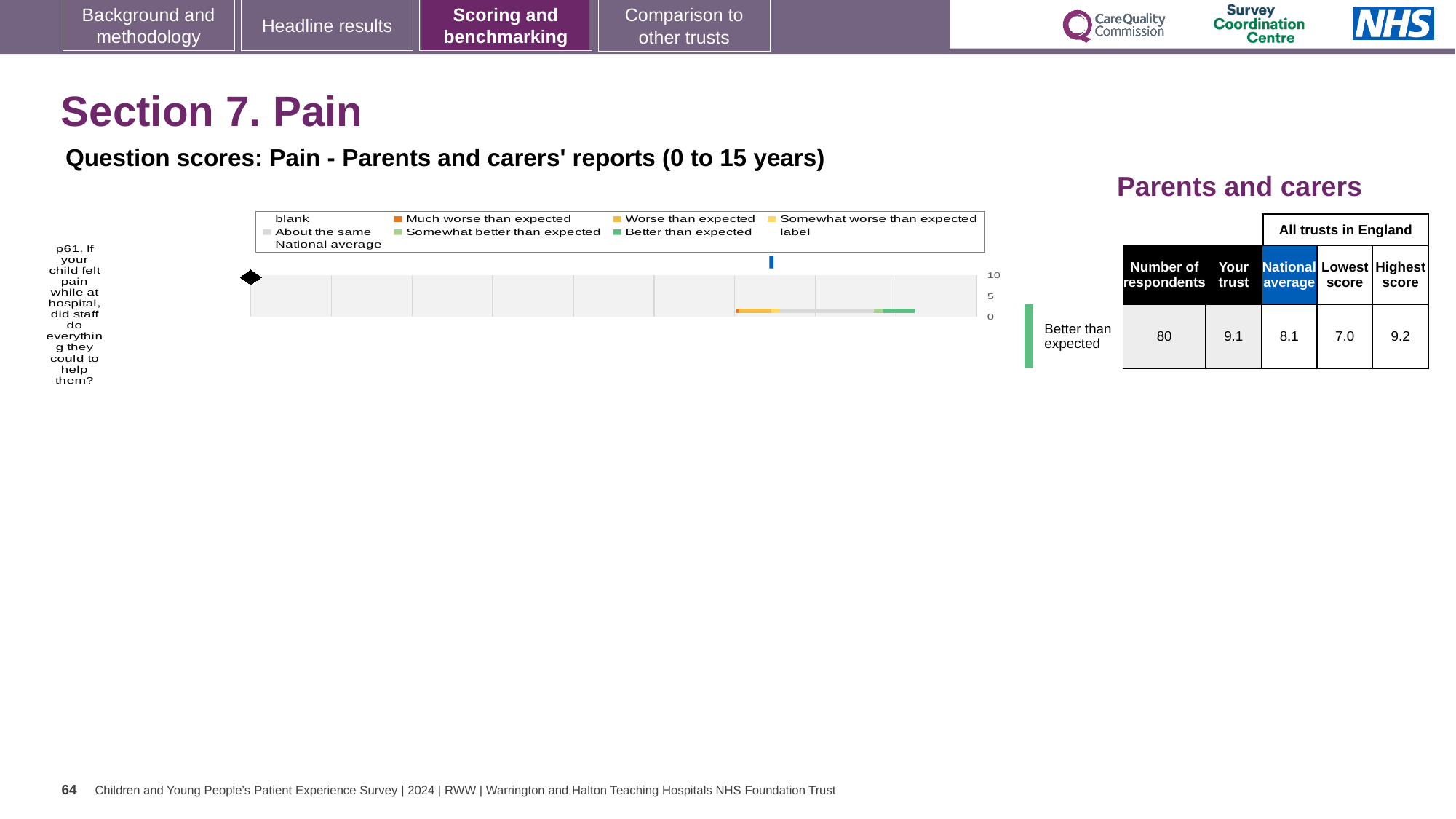
What is the national average score for question p61? 8.1 How many respondents answered question p61? 80 What kind of chart is used to show the p61 question score? bar chart What is the highest score among all trusts in England for question p61? 9.2 How many survey questions are plotted in the chart? 1 Which is higher for question p61: the trust's score or the national average? Your trust What is the lowest score among all trusts in England for question p61? 7.0 What colour does the legend use for 'Better than expected'? green By how much does the trust's score for p61 exceed the national average? 1.0 What is the 'Your trust' score for question p61? 9.1 What is the difference between the highest and lowest scores for question p61? 2.2 Which benchmarking category does the trust's result for p61 fall into? Better than expected